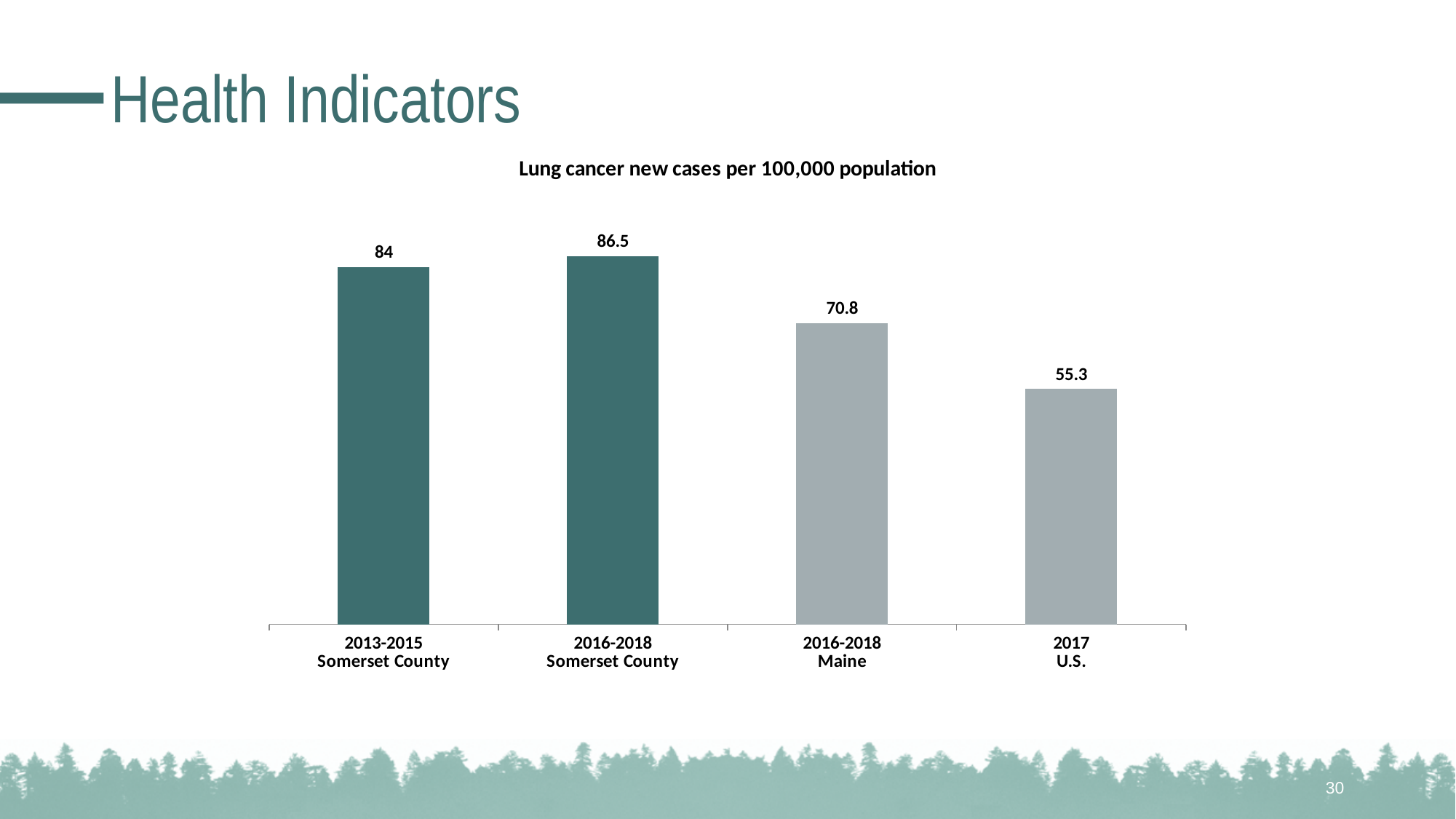
What is the difference between the 2016-2018 Somerset County value and the 2016-2018 Maine value? 15.7 What is the value for 2017 U.S.? 55.3 What is the value for 2016-2018 Somerset County? 86.5 How many bars are shown in the chart? 4 Which category has the highest value? 2016-2018 Somerset County What is the value for 2013-2015 Somerset County? 84 What is the value for 2016-2018 Maine? 70.8 What is the title of the chart? Lung cancer new cases per 100,000 population Which category has the lowest value? 2017 U.S. What is the difference between the 2016-2018 Maine value and the 2017 U.S. value? 15.5 Which is larger, the value for 2016-2018 Maine or the value for 2017 U.S.? 2016-2018 Maine What kind of chart is shown on the slide? Bar chart